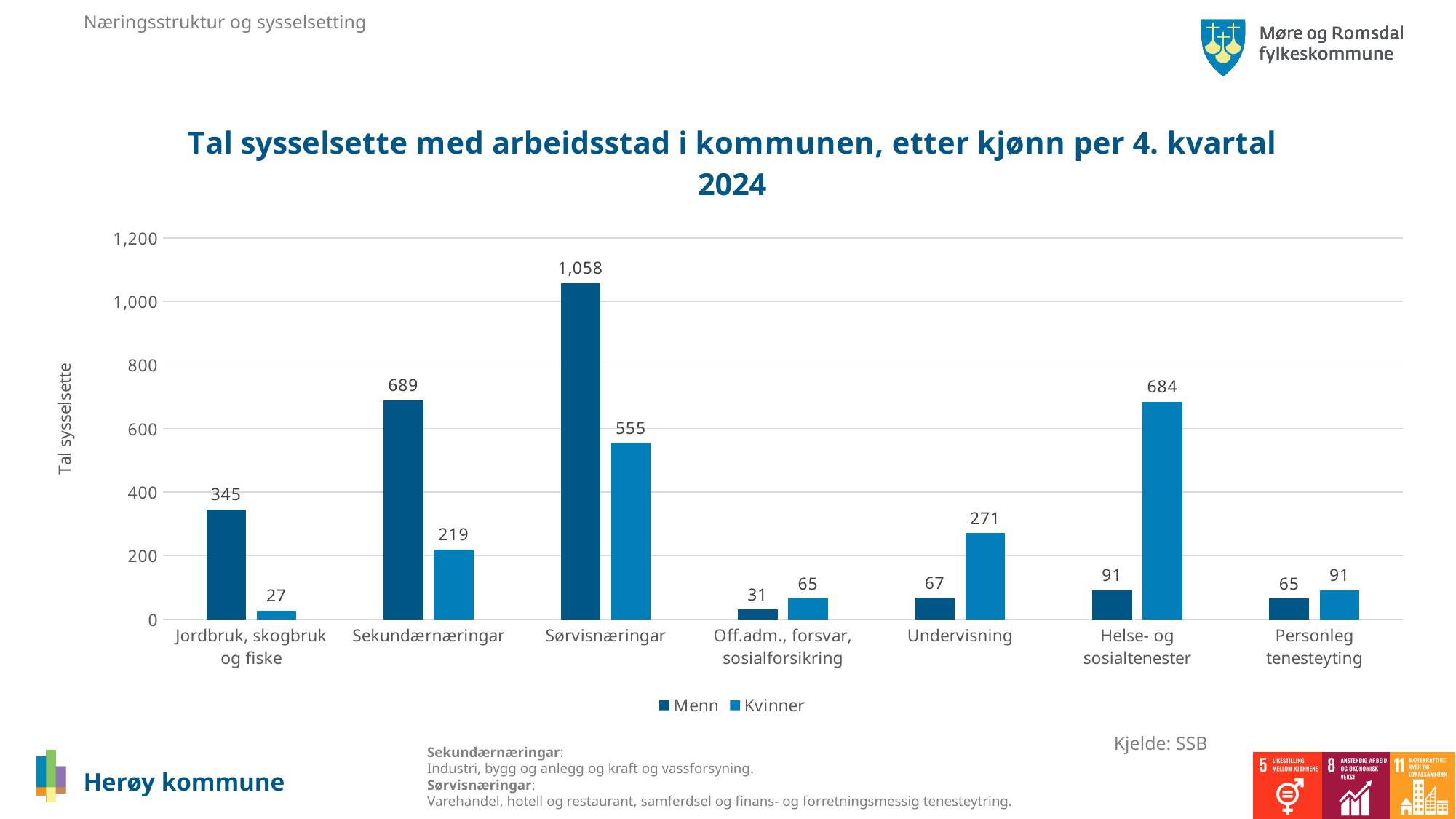
Which category has the lowest value for Kvinner? Jordbruk, skogbruk og fiske Which is larger in Undervisning, Menn or Kvinner? Kvinner What is the value for Kvinner in Helse- og sosialtenester? 684 What is the label of the y axis? Tal sysselsette What kind of chart is shown on the slide? bar chart What is the value for Kvinner in Jordbruk, skogbruk og fiske? 27 What is the difference between Menn and Kvinner in Sekundærnæringar? 470 Which category has the highest value for Menn? Sørvisnæringar What is the value for Menn in Sørvisnæringar? 1,058 Is the value for Kvinner in Sørvisnæringar greater or less than 600? less How many series does the legend list? 2 How many categories are shown on the x axis? 7